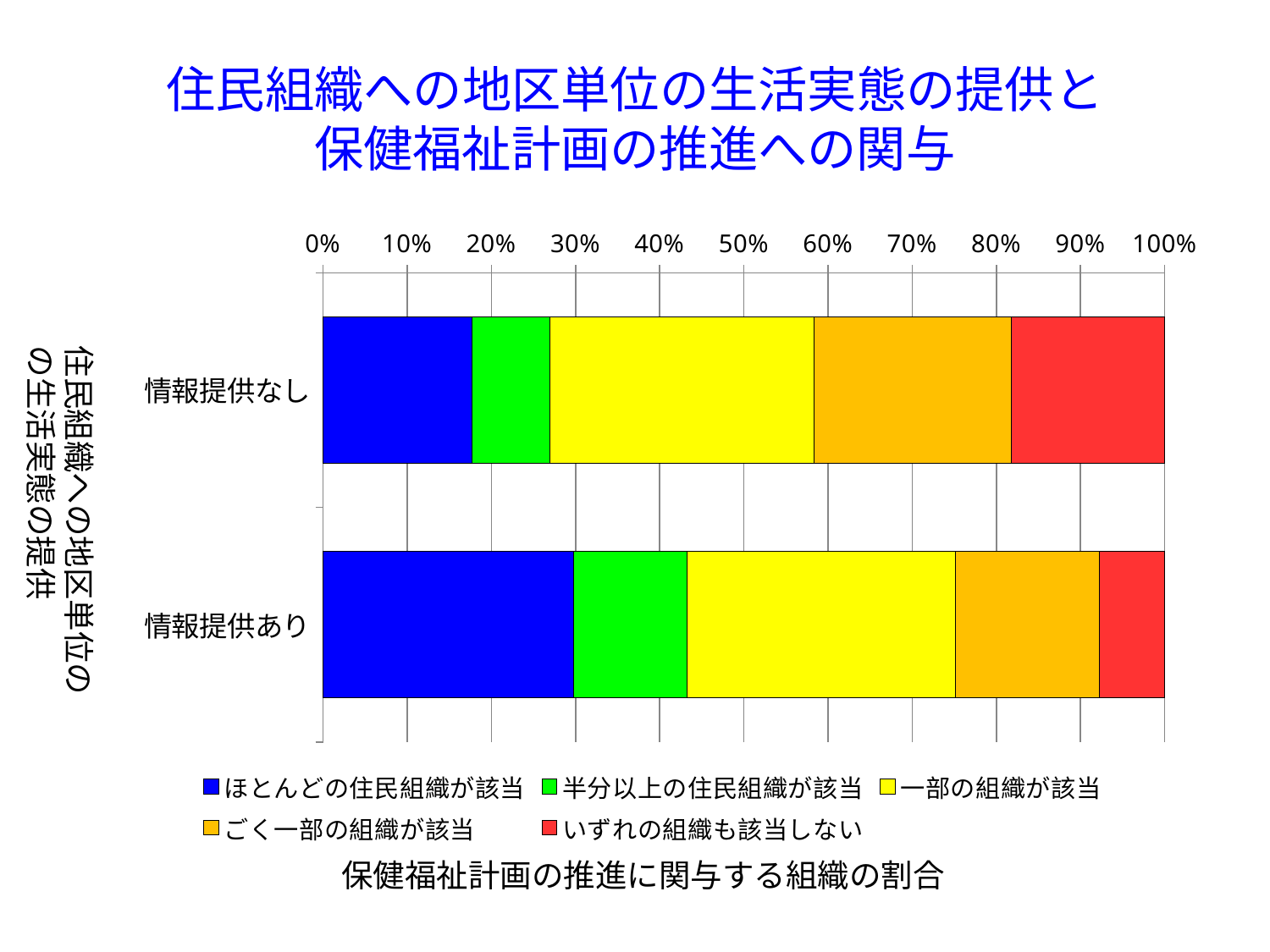
How many series does the legend list? 5 Is the value of ほとんどの住民組織が該当 for 情報提供あり greater or less than 20%? greater Which colour represents 一部の組織が該当 in the legend? Yellow Is the value of いずれの組織も該当しない for 情報提供なし greater or less than 10%? greater Which category has the larger share of ごく一部の組織が該当, 情報提供なし or 情報提供あり? 情報提供なし How many categories (bars) are plotted on the chart? 2 What is the total of the stacked bar for 情報提供あり? 100% Is the value of いずれの組織も該当しない for 情報提供あり greater or less than 20%? less Which category has the larger share of いずれの組織も該当しない, 情報提供なし or 情報提供あり? 情報提供なし What kind of chart is shown on the slide? Stacked bar chart Which category has the larger share of ほとんどの住民組織が該当, 情報提供なし or 情報提供あり? 情報提供あり What is the title of the chart on the slide? 住民組織への地区単位の生活実態の提供と保健福祉計画の推進への関与